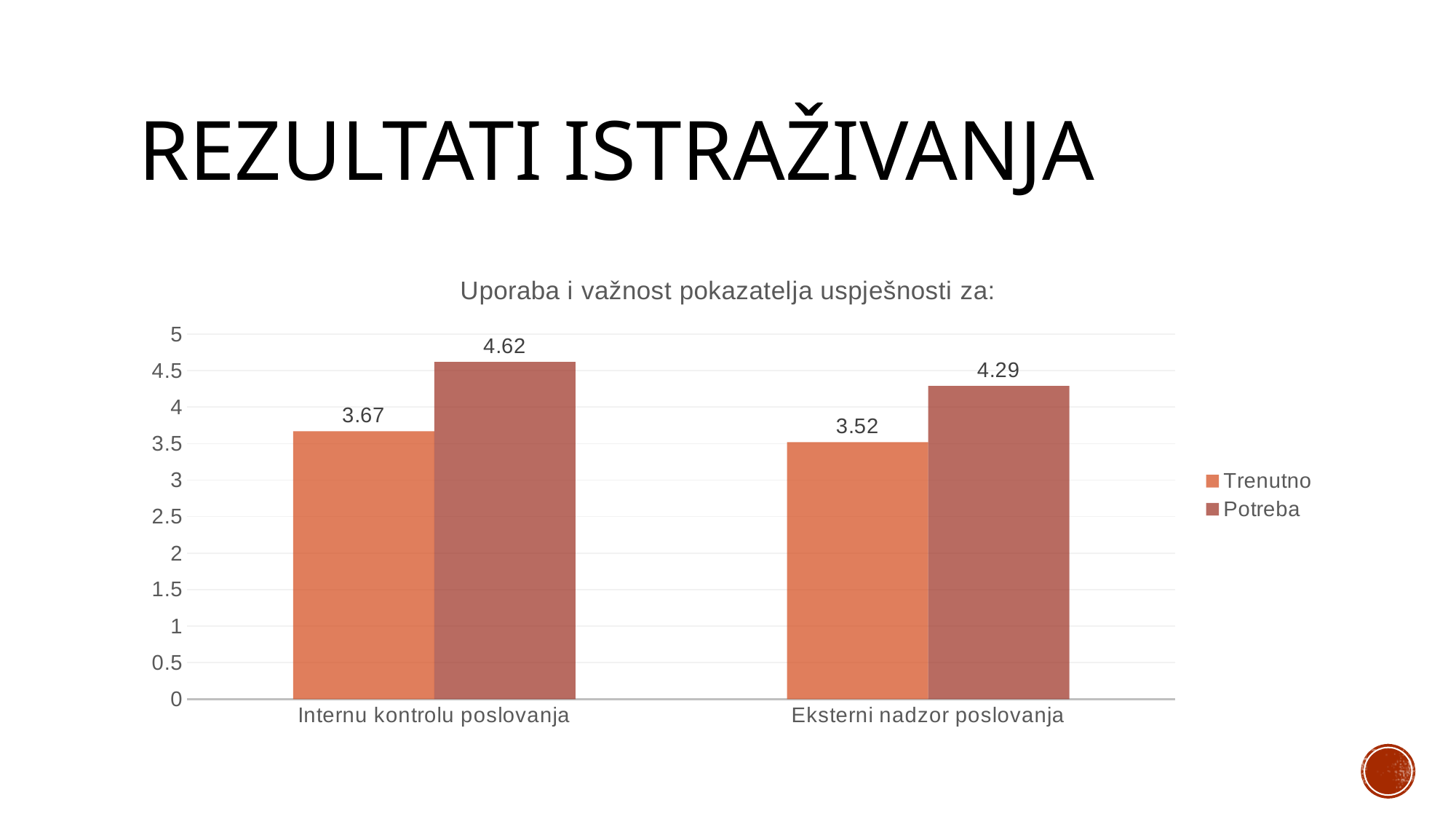
Which category has the highest Potreba value? Internu kontrolu poslovanja What is the Potreba value for Internu kontrolu poslovanja? 4.62 What is the difference between the Potreba and Trenutno values for Eksterni nadzor poslovanja? 0.77 What is the Trenutno value for Eksterni nadzor poslovanja? 3.52 How many categories are shown on the x axis? 2 How many series does the legend list? 2 What is the Trenutno value for Internu kontrolu poslovanja? 3.67 What kind of chart is shown on the slide? Bar chart What is the Potreba value for Eksterni nadzor poslovanja? 4.29 Which is larger for Eksterni nadzor poslovanja, Trenutno or Potreba? Potreba Which category has the lowest Trenutno value? Eksterni nadzor poslovanja What is the difference between the Potreba and Trenutno values for Internu kontrolu poslovanja? 0.95